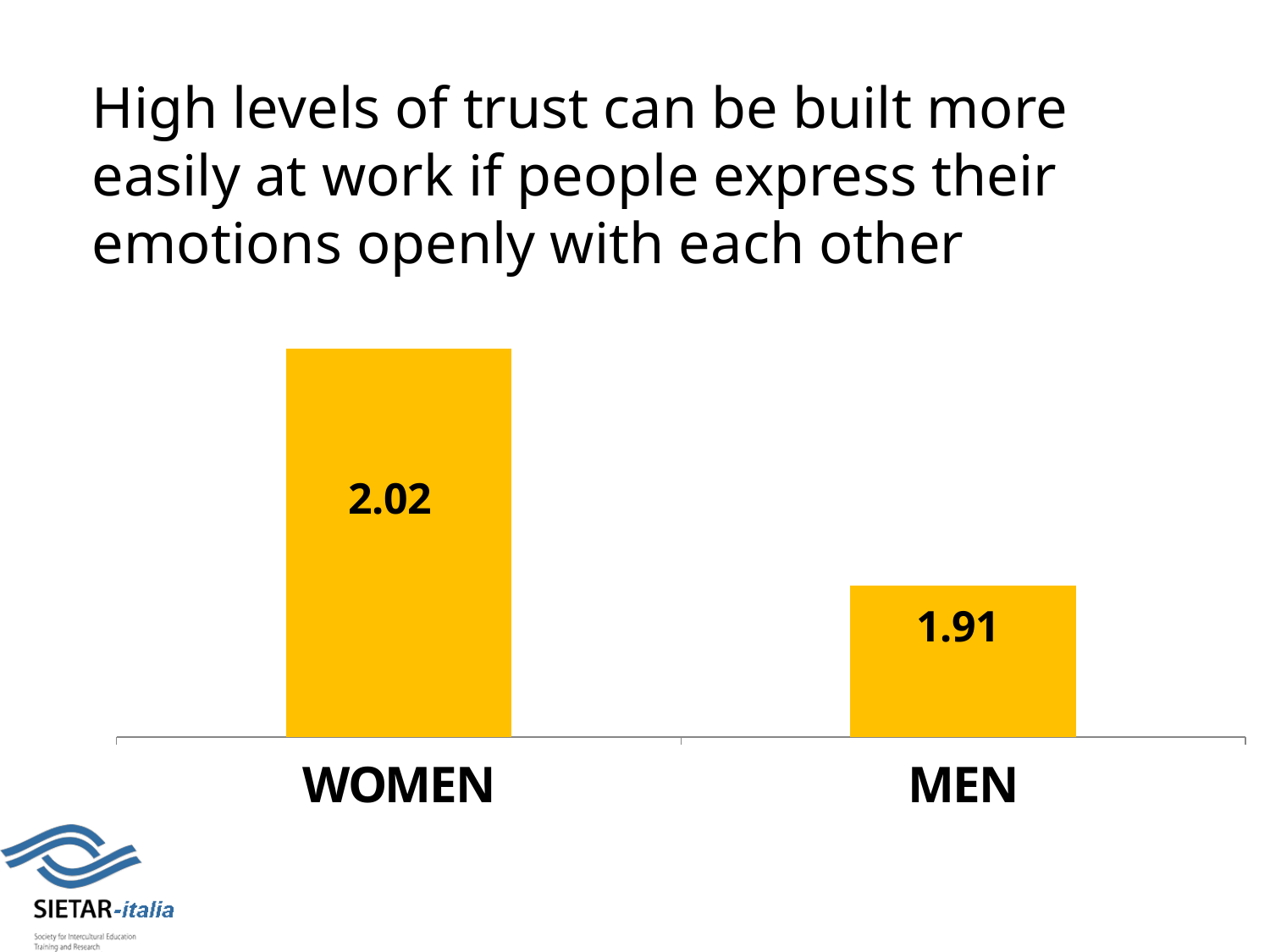
What kind of chart is shown on the slide? Bar chart Which category has the lowest value? MEN Which is larger, the value for WOMEN or the value for MEN? WOMEN What colour are the bars in the chart? Yellow What is the difference between the values for WOMEN and MEN? 0.11 What is the value for WOMEN? 2.02 Which category has the highest value? WOMEN What is the value for MEN? 1.91 How many categories are shown in the chart? 2 What are the two category labels on the x axis? WOMEN and MEN